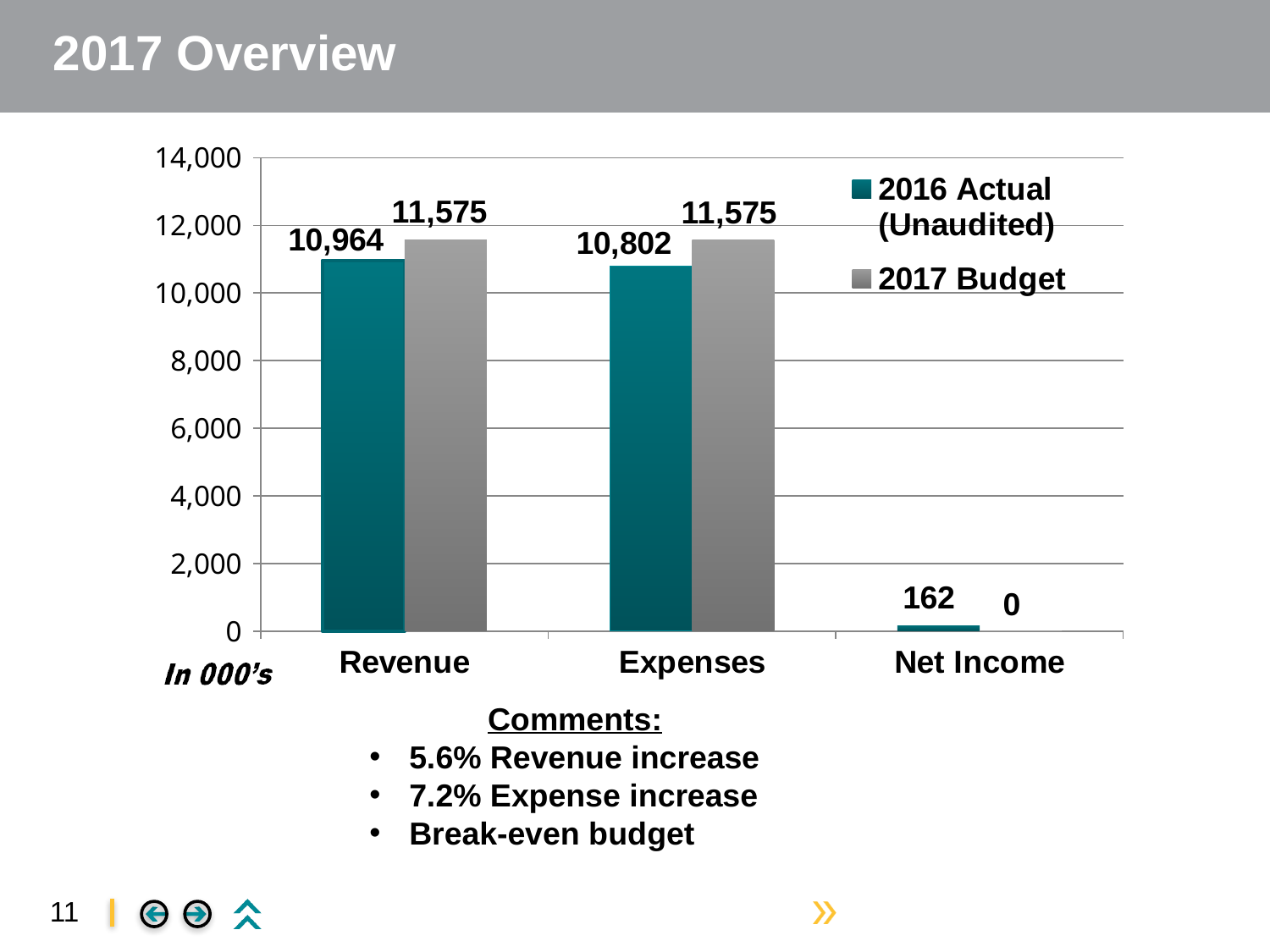
Which is larger for Expenses: the 2016 Actual (Unaudited) value or the 2017 Budget value? 2017 Budget How many categories are shown on the x axis? 3 What is the 2017 Budget value for Net Income? 0 What is the difference between the 2017 Budget and 2016 Actual (Unaudited) values for Revenue? 611 Is the 2016 Actual (Unaudited) value for Expenses greater or less than 12,000? less What kind of chart is shown on the slide? bar chart What is the difference between the 2016 Actual (Unaudited) values for Revenue and Expenses? 162 Which category has the lowest 2016 Actual (Unaudited) value? Net Income What is the 2016 Actual (Unaudited) value for Revenue? 10,964 What is the 2016 Actual (Unaudited) value for Net Income? 162 How many series does the legend list? 2 What is the 2017 Budget value for Expenses? 11,575